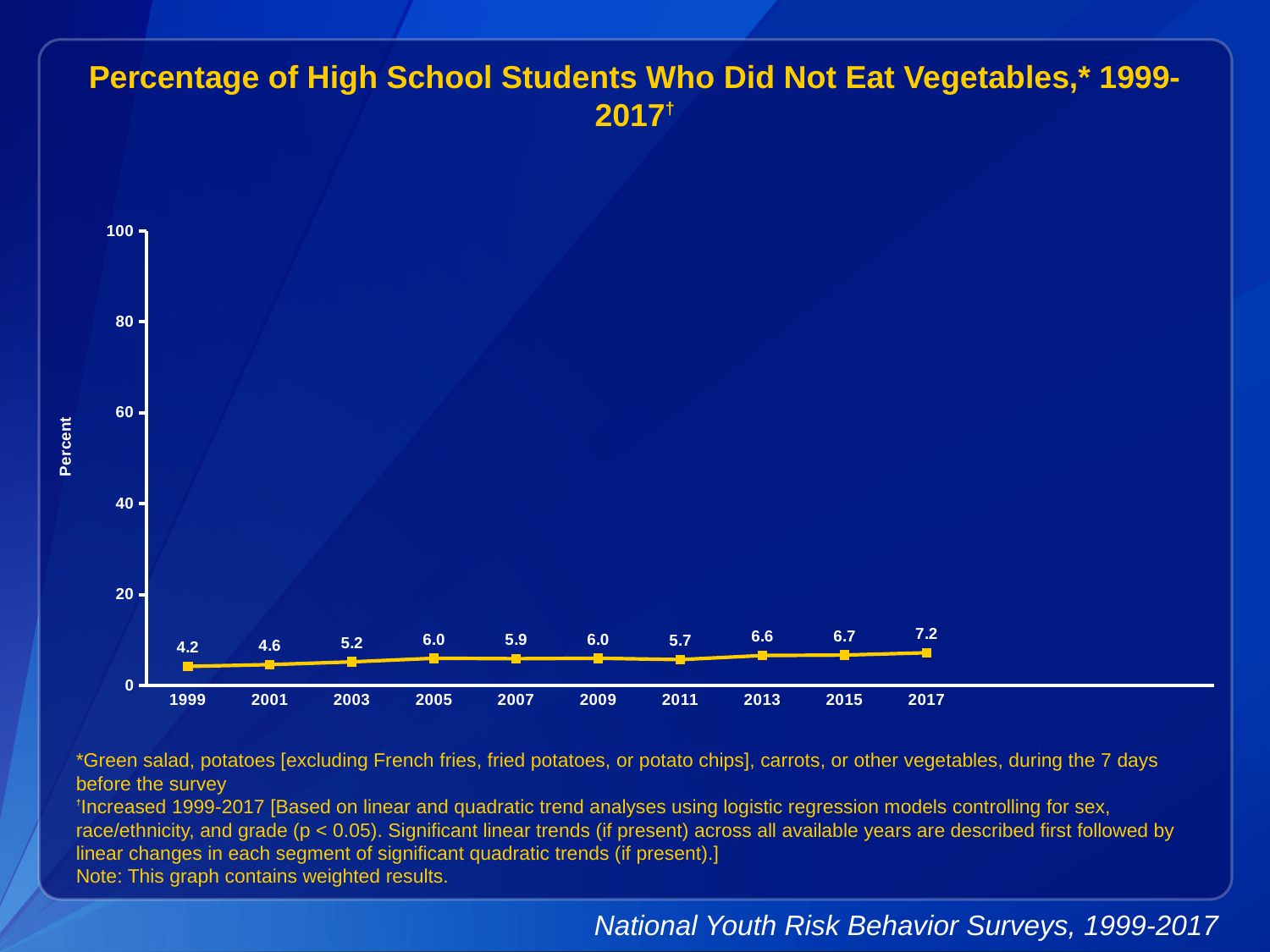
What is the difference between the values for 2017 and 1999? 3.0 How many years are plotted on the chart? 10 Do the values generally rise or fall from 1999 to 2017? rise Which is larger, the value for 2013 or the value for 2011? 2013 Which year has the highest value? 2017 What is the value for 2017? 7.2 What is the value for 2011? 5.7 What kind of chart is shown? line chart What is the label on the y axis? Percent Is the value for 2017 greater or less than 20? less What is the value for 1999? 4.2 Which year has the lowest value? 1999